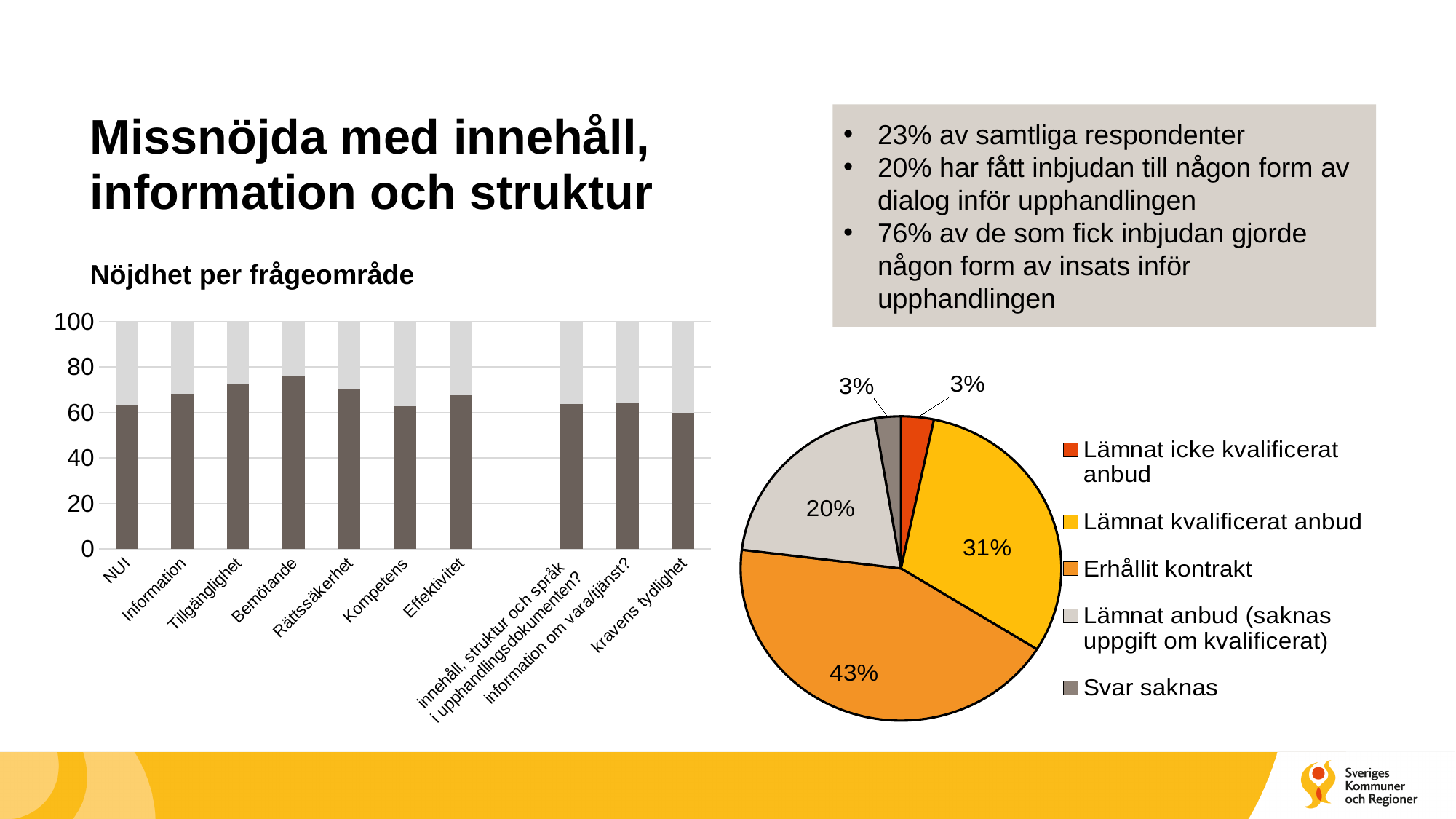
In the pie chart, what share is labelled for Erhållit kontrakt? 43% In the pie chart, what share is labelled for Lämnat anbud (saknas uppgift om kvalificerat)? 20% In the pie chart, what is the difference between the Erhållit kontrakt share and the Lämnat kvalificerat anbud share? 12% How many categories are shown on the x axis of the 'Nöjdhet per frågeområde' chart? 10 In the 'Nöjdhet per frågeområde' chart, is the dark bar for Bemötande greater or less than 60? greater In the 'Nöjdhet per frågeområde' chart, is the dark bar for kravens tydlighet greater or less than 80? less In the 'Nöjdhet per frågeområde' chart, which category has the highest dark bar? Bemötande What kind of chart is 'Nöjdhet per frågeområde'? Bar chart In the pie chart, what share is labelled for Lämnat kvalificerat anbud? 31% In the pie chart, which category has the largest slice? Erhållit kontrakt In the pie chart, which is larger: Lämnat kvalificerat anbud or Lämnat anbud (saknas uppgift om kvalificerat)? Lämnat kvalificerat anbud How many entries does the legend of the pie chart list? 5